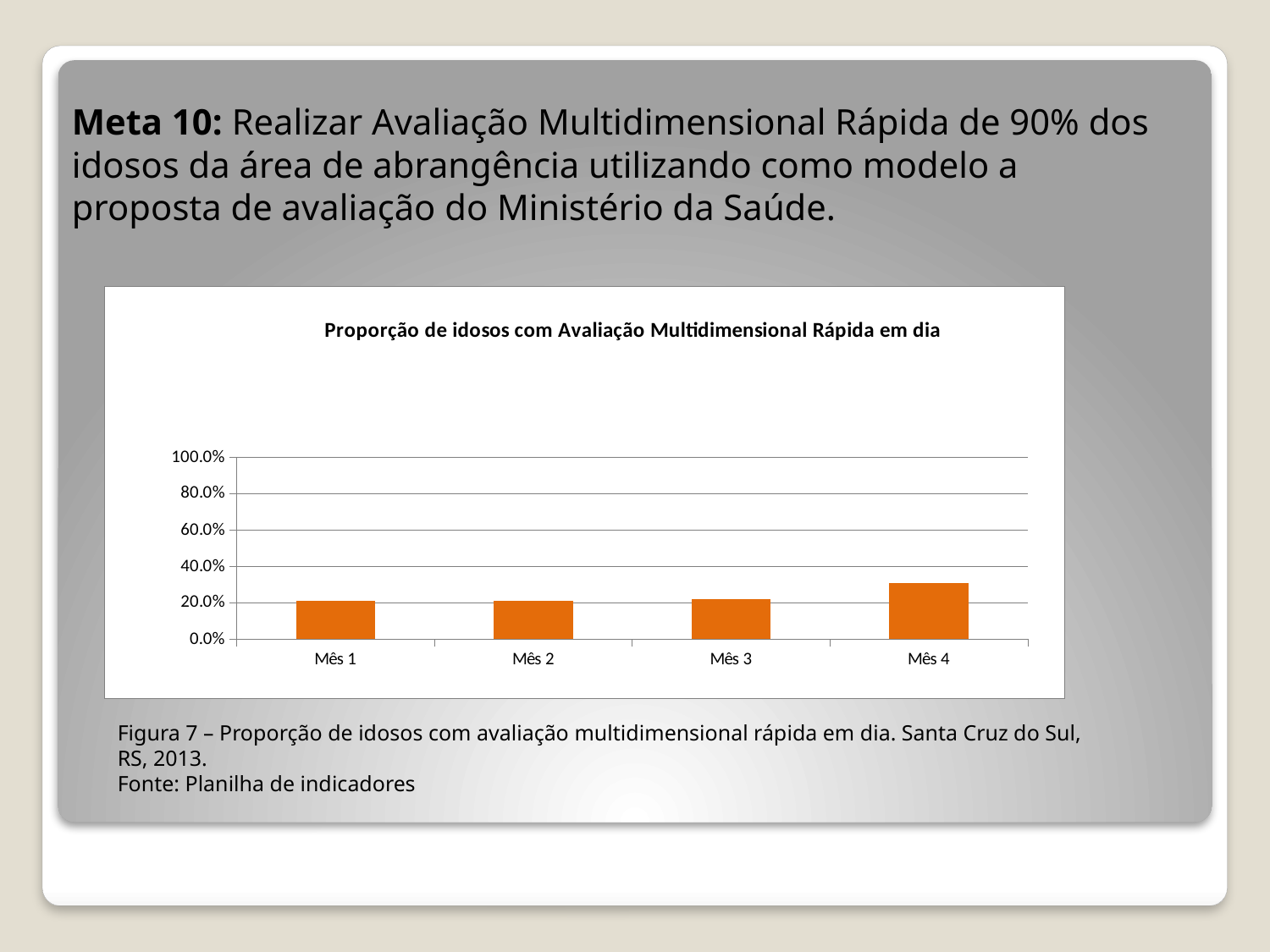
What is the title of the chart? Proporção de idosos com Avaliação Multidimensional Rápida em dia What is the highest value shown on the y axis of the chart? 100.0% Is the value for Mês 1 greater or less than 40.0%? less Which is larger, the value for Mês 2 or the value for Mês 4? Mês 4 How many months (categories) are shown on the x axis of the chart? 4 Is the value for Mês 4 greater or less than 40.0%? less What kind of chart is shown on the slide? bar chart Is the value for Mês 4 greater or less than 20.0%? greater Which month has the highest proportion of idosos com Avaliação Multidimensional Rápida em dia? Mês 4 Which is larger, the value for Mês 4 or the value for Mês 1? Mês 4 Do the values generally rise or fall from Mês 1 to Mês 4? rise